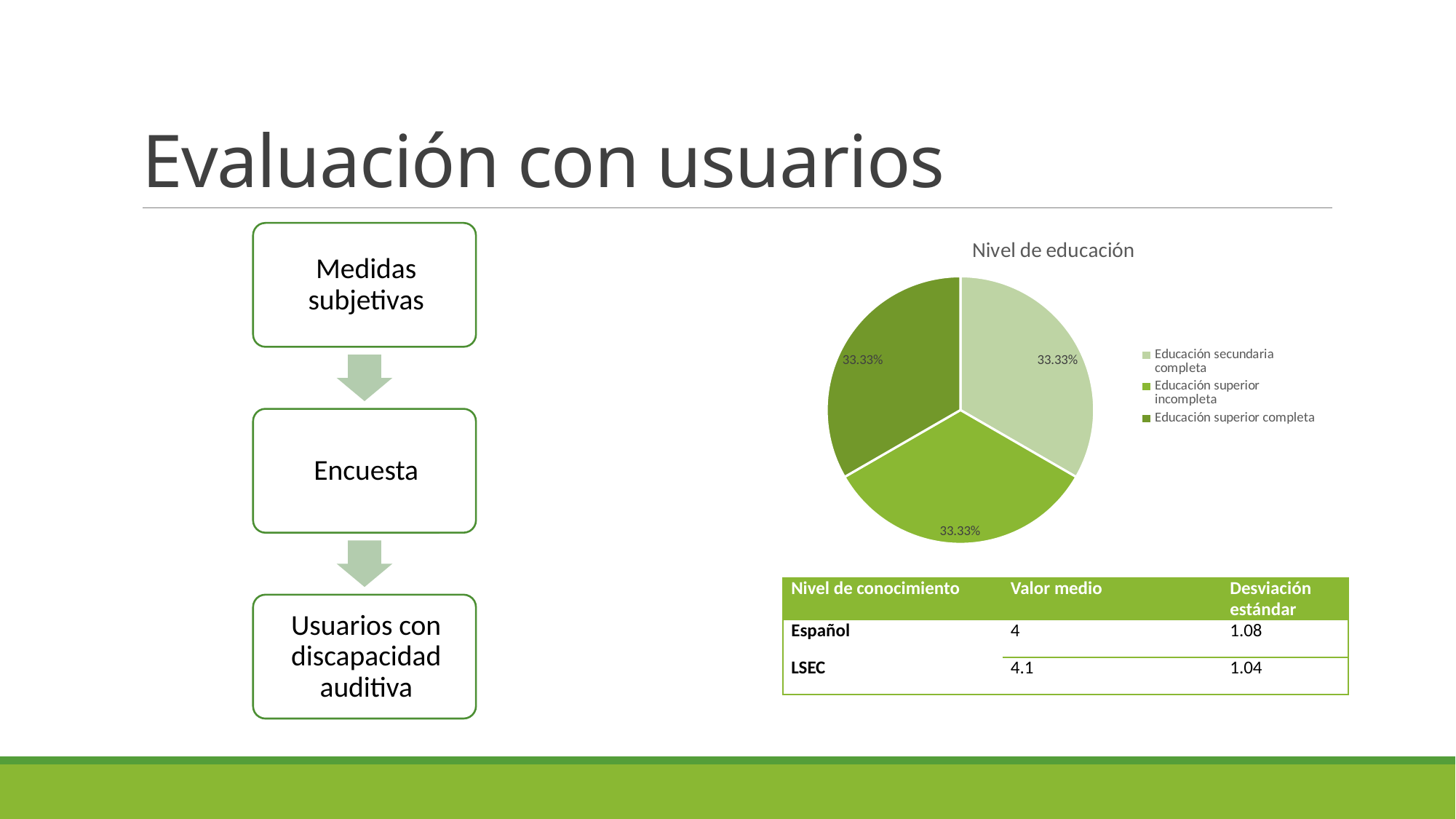
Which legend entry in the "Nivel de educación" pie chart is shown in the darkest green? Educación superior completa How many slices does the "Nivel de educación" pie chart have? 3 What share of the "Nivel de educación" pie is "Educación superior completa"? 33.33% What type of chart is shown under the title "Nivel de educación"? pie chart What share of the "Nivel de educación" pie is "Educación superior incompleta"? 33.33% What is the title of the pie chart? Nivel de educación In the "Nivel de educación" pie chart, what is the difference between the shares of "Educación superior completa" and "Educación secundaria completa"? 0% What share of the "Nivel de educación" pie is "Educación secundaria completa"? 33.33% How many entries does the legend of the "Nivel de educación" pie chart list? 3 In the "Nivel de educación" pie chart, is the share for "Educación superior incompleta" greater or less than 50%? less